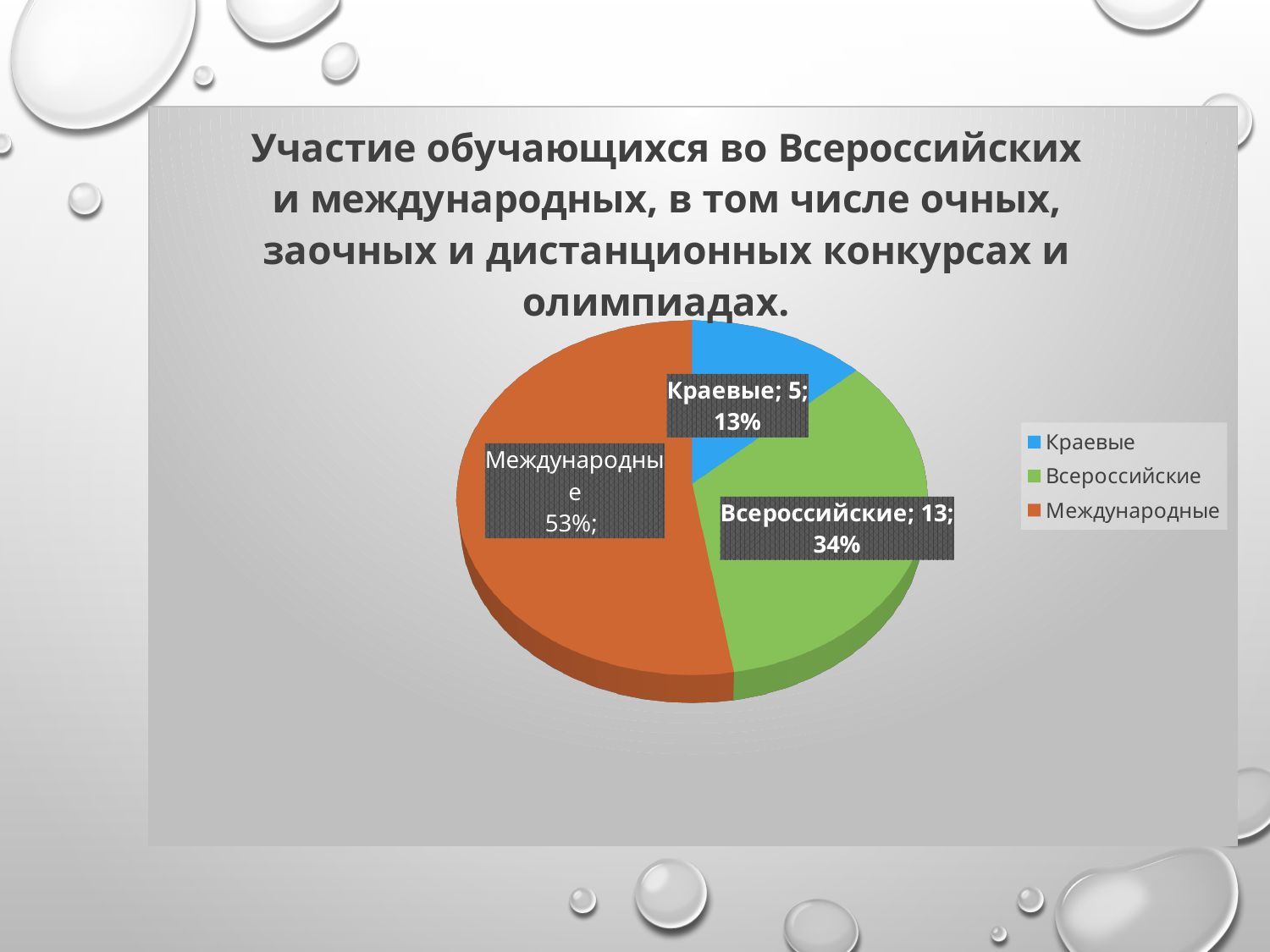
Which colour represents Международные in the pie chart? orange How many slices does the pie chart have? 3 What is the difference between the values for Всероссийские and Краевые? 8 What kind of chart is shown on the slide? pie chart What share of the pie does Краевые represent? 13% What is the value shown for Краевые? 5 What share of the pie does Всероссийские represent? 34% Which category has the smallest slice of the pie? Краевые Which category has the largest slice of the pie? Международные What is the value shown for Всероссийские? 13 What share of the pie does Международные represent? 53% How many entries does the legend list? 3